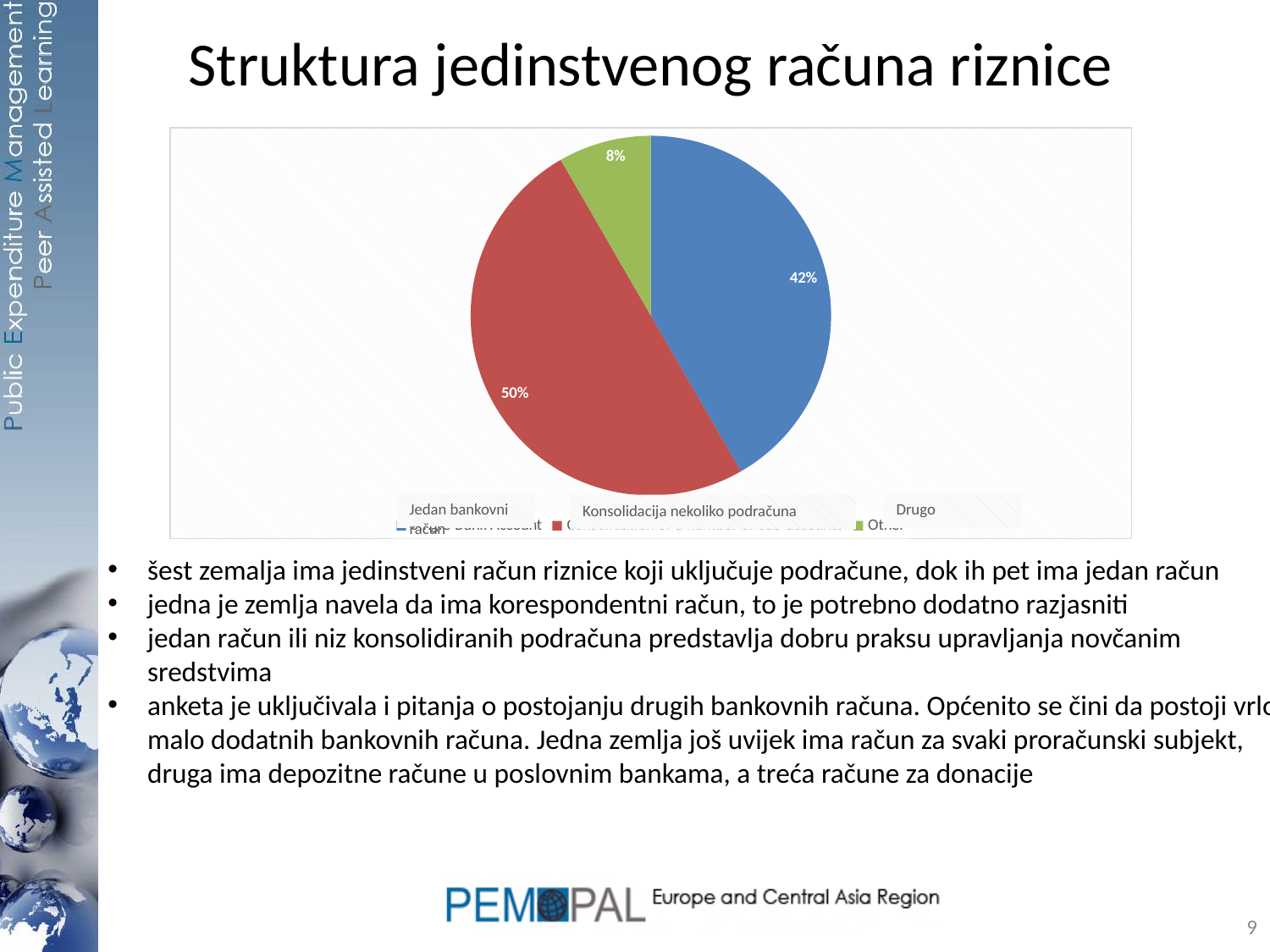
What is the difference in percentage points between the 'Jedan bankovni račun' slice and the 'Drugo' slice? 34 Which category has the smallest slice of the pie? Drugo Which slice is larger, 'Jedan bankovni račun' or 'Drugo'? Jedan bankovni račun How many slices does the pie chart have? 3 What is the title of the slide containing the pie chart? Struktura jedinstvenog računa riznice What colour is the slice labelled 'Drugo'? green What share of the pie does the slice labelled 'Drugo' represent? 8% What kind of chart is shown on the slide? pie chart Which category has the largest slice of the pie? Konsolidacija nekoliko podračuna What is the difference in percentage points between the 'Konsolidacija nekoliko podračuna' slice and the 'Jedan bankovni račun' slice? 8 What share of the pie does the slice labelled 'Jedan bankovni račun' represent? 42% What share of the pie does the slice labelled 'Konsolidacija nekoliko podračuna' represent? 50%